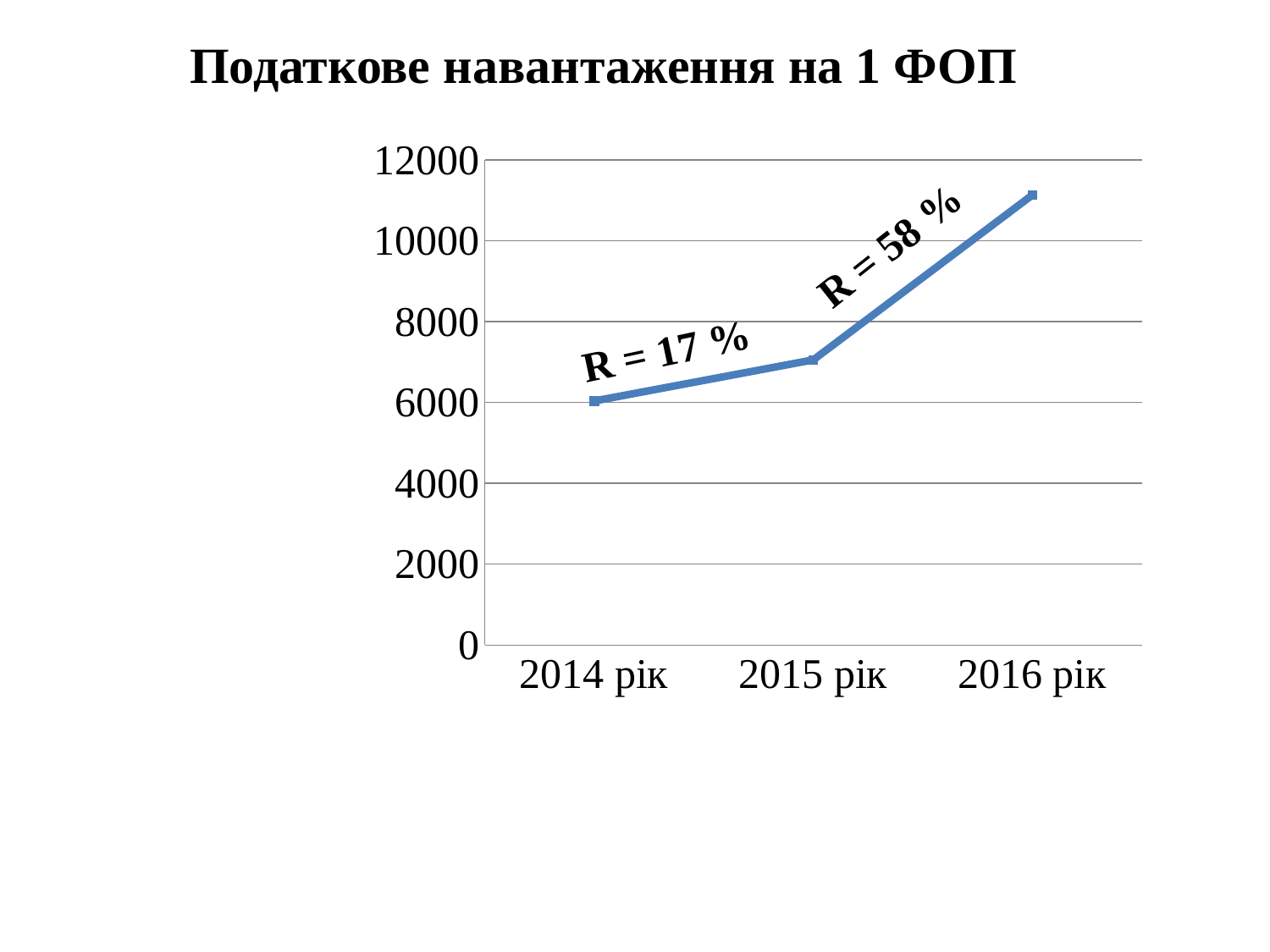
Which year has the lowest value? 2014 рік Which is larger, the value for 2016 рік or the value for 2014 рік? 2016 рік Which year has the highest value? 2016 рік Is the value for 2014 рік greater or less than 8000? less Is the value for 2016 рік greater or less than 10000? greater Is the value for 2015 рік greater or less than 8000? less What is the title of the chart? Податкове навантаження на 1 ФОП How many years are plotted on the x axis? 3 What kind of chart is shown on the slide? line chart What growth rate is annotated on the segment between 2015 рік and 2016 рік? R = 58 % Do the values rise or fall from 2014 рік to 2016 рік? rise